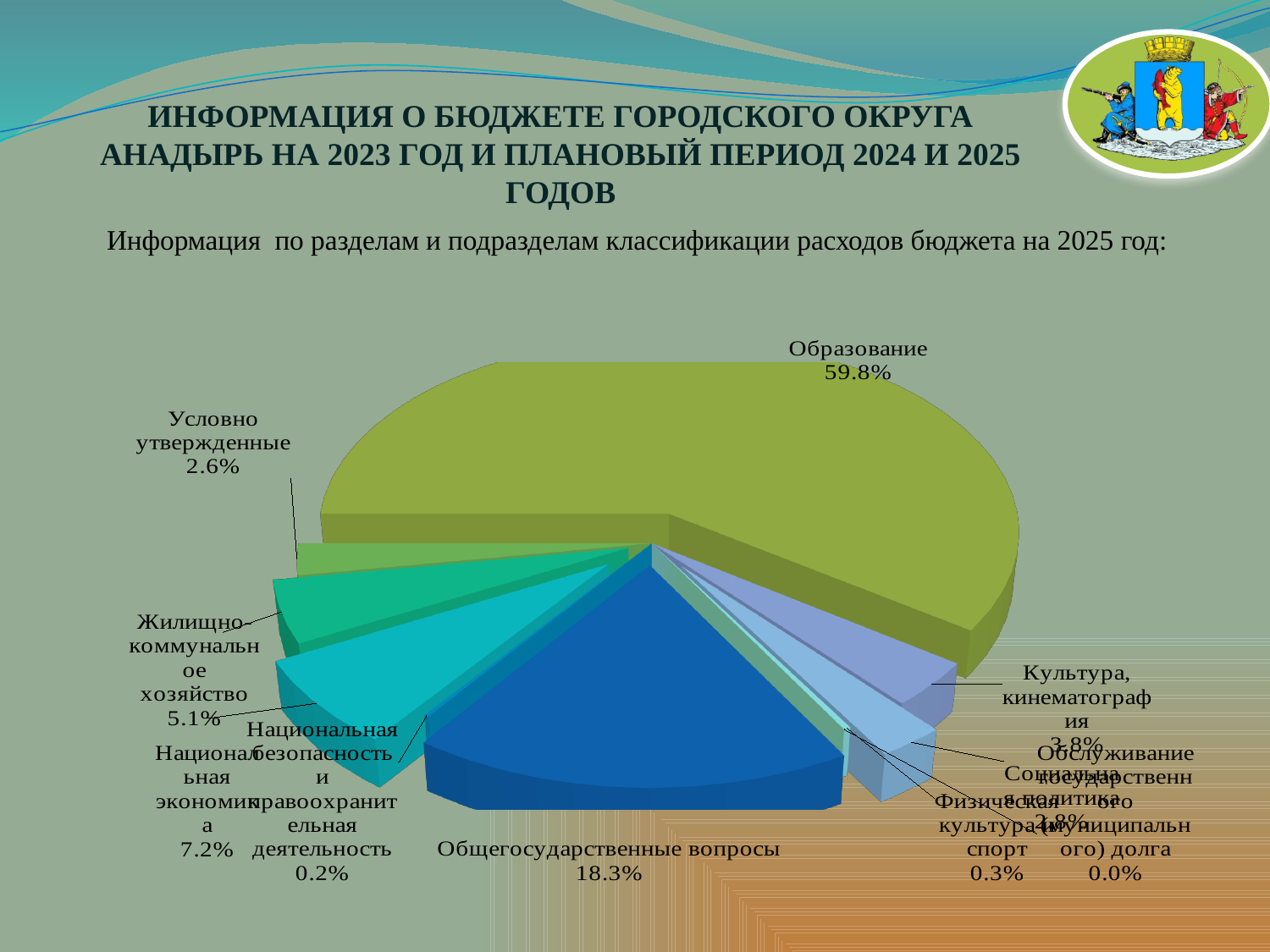
What share of the budget expenditure does Образование account for? 59.8% What is the value shown for Общегосударственные вопросы? 18.3% What is the value shown for Физическая культура и спорт? 0.3% What kind of chart is shown on the slide? Pie chart What percentage is labelled for Условно утвержденные? 2.6% For which year does the chart show the breakdown of budget expenditure? 2025 By how many percentage points does Образование exceed Общегосударственные вопросы? 41.5 percentage points What is the value for Жилищно-коммунальное хозяйство? 5.1% Which category has the smallest value in the chart? Обслуживание государственного (муниципального) долга Which category has the largest slice of the pie? Образование Which is larger: Национальная экономика or Жилищно-коммунальное хозяйство? Национальная экономика What percentage is shown for Национальная экономика? 7.2%